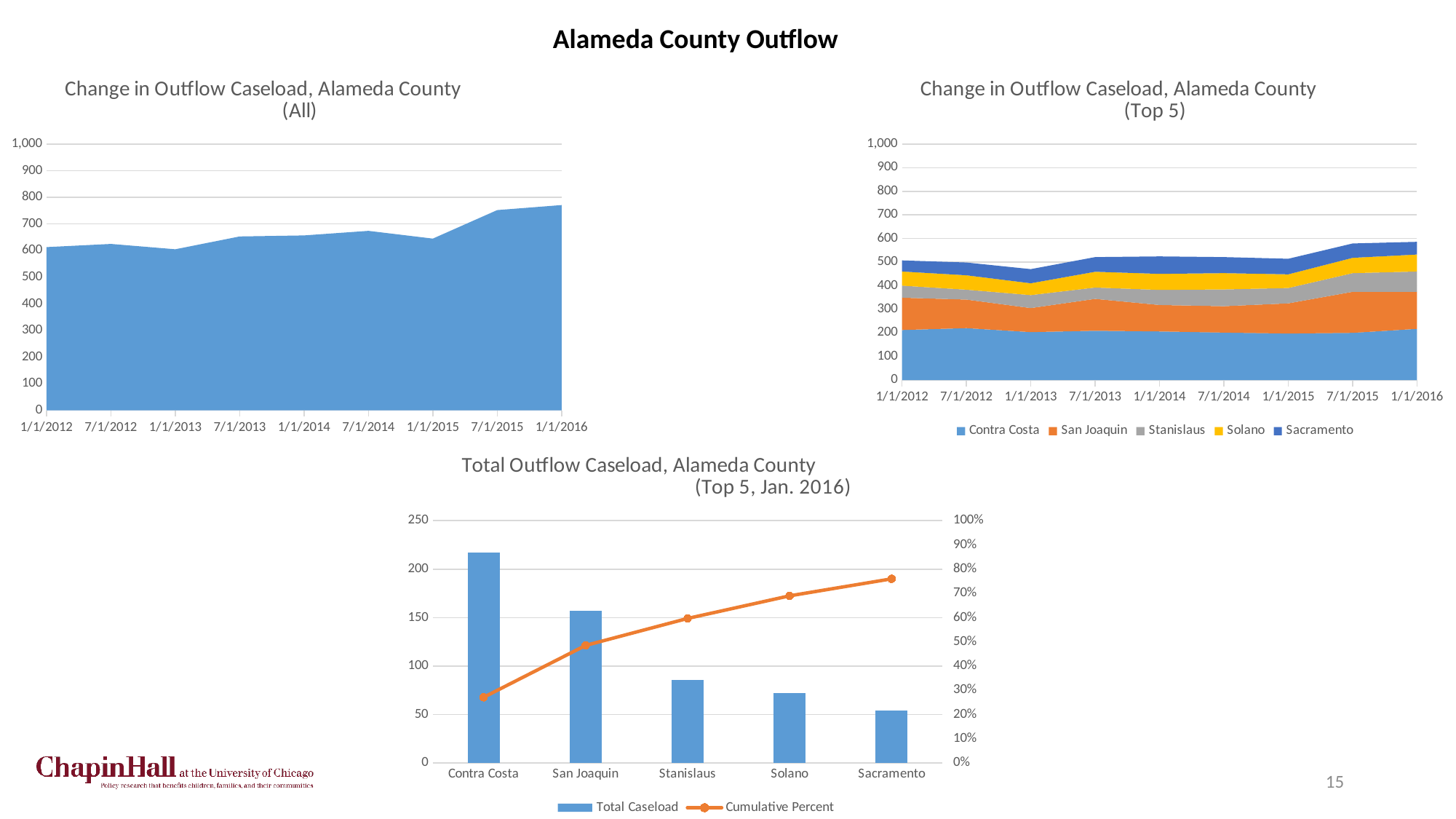
How many series does the legend of the Total Outflow Caseload, Alameda County (Top 5, Jan. 2016) chart list? 2 In the Total Outflow Caseload, Alameda County (Top 5, Jan. 2016) chart, is the total caseload for Contra Costa greater or less than 200? greater In the Total Outflow Caseload, Alameda County (Top 5, Jan. 2016) chart, which county has the highest total caseload? Contra Costa In the Total Outflow Caseload, Alameda County (Top 5, Jan. 2016) chart, is the cumulative percent for Contra Costa greater or less than 30%? less In the Total Outflow Caseload, Alameda County (Top 5, Jan. 2016) chart, which county has the lowest total caseload? Sacramento In the Change in Outflow Caseload, Alameda County (Top 5) chart, which series is listed first in the legend? Contra Costa What kind of chart is the Change in Outflow Caseload, Alameda County (All) chart? area chart How many series does the legend of the Change in Outflow Caseload, Alameda County (Top 5) chart list? 5 How many counties are shown on the x axis of the Total Outflow Caseload, Alameda County (Top 5, Jan. 2016) chart? 5 In the Total Outflow Caseload, Alameda County (Top 5, Jan. 2016) chart, is the total caseload for Stanislaus greater or less than 100? less In the Total Outflow Caseload, Alameda County (Top 5, Jan. 2016) chart, which has the larger total caseload, San Joaquin or Solano? San Joaquin